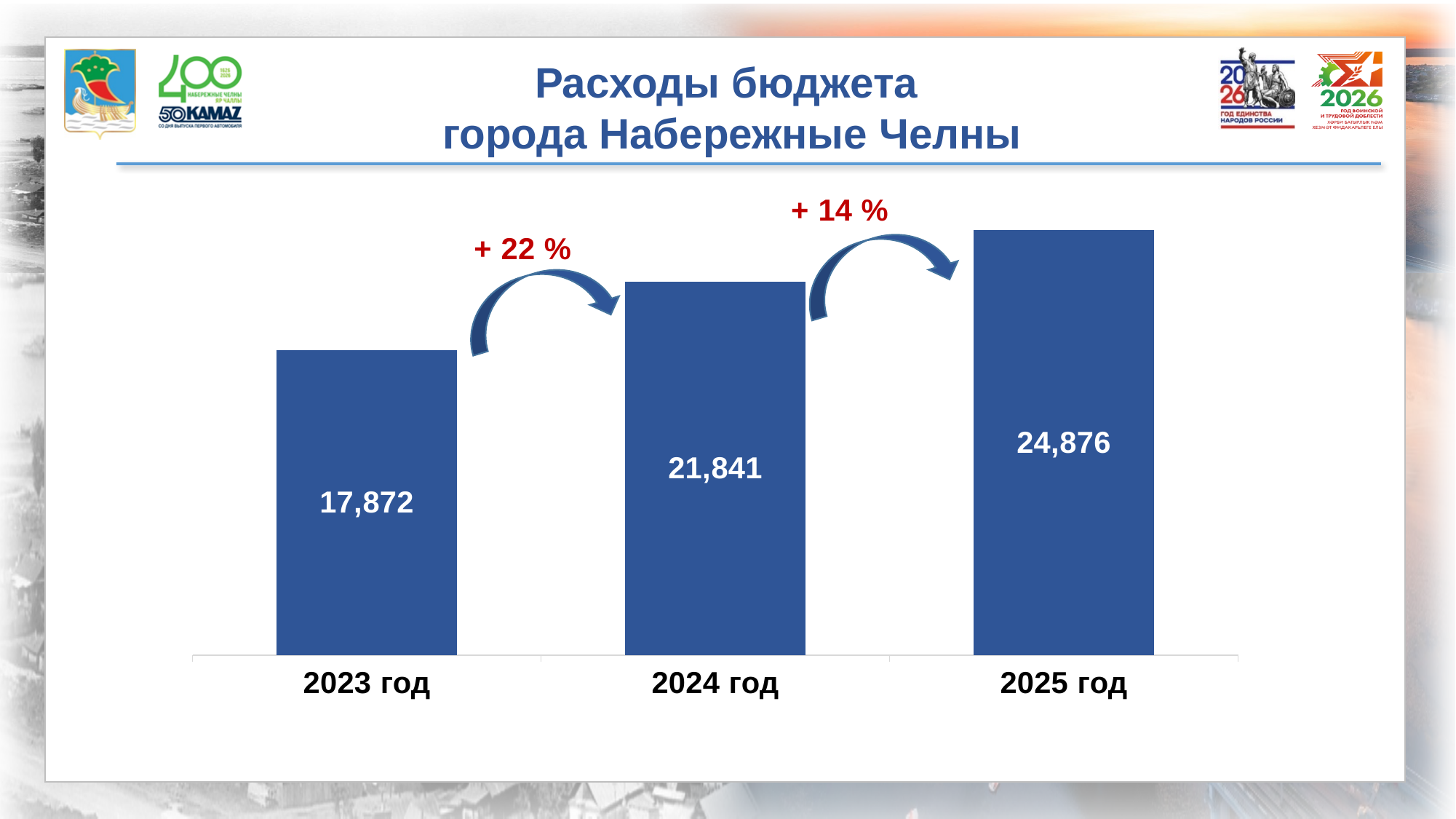
What is the value for 2025 год? 24,876 Which year has the lowest value? 2023 год What percentage increase is shown between 2023 год and 2024 год? + 22 % What is the difference between the values for 2024 год and 2023 год? 3,969 What is the value for 2024 год? 21,841 How many bars are shown in the chart? 3 Which year has the highest value? 2025 год What is the difference between the values for 2025 год and 2024 год? 3,035 Do the values rise or fall from 2023 год to 2025 год? Rise What is the value for 2023 год? 17,872 Which is larger, the value for 2023 год or the value for 2025 год? 2025 год What kind of chart is shown on the slide? Bar chart